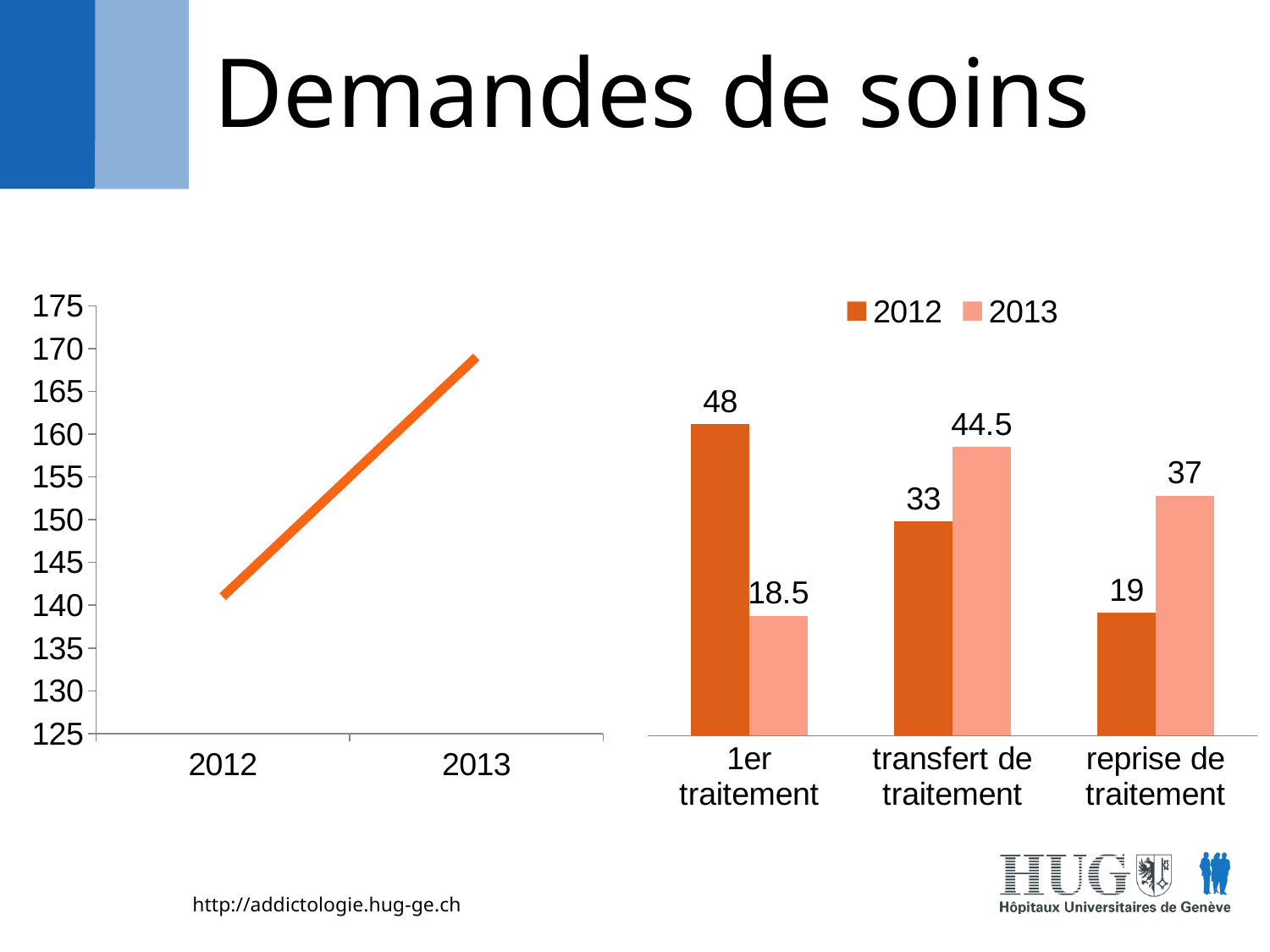
In the bar chart on the right, how many series does the legend list? 2 In the bar chart on the right, what is the 2013 value for reprise de traitement? 37 In the line chart on the left, is the value for 2012 greater or less than 145? less In the line chart on the left, does the value rise or fall from 2012 to 2013? rise In the bar chart on the right, which category has the highest 2012 value? 1er traitement What kind of chart is the chart on the left of the slide? line chart In the bar chart on the right, what is the 2013 value for transfert de traitement? 44.5 In the bar chart on the right, what is the difference between the 2012 and 2013 values for 1er traitement? 29.5 In the bar chart on the right, which category has the lowest 2013 value? 1er traitement In the bar chart on the right, what is the 2012 value for 1er traitement? 48 In the bar chart on the right, how many categories are shown on the x axis? 3 In the bar chart on the right, which is larger for reprise de traitement: the 2012 value or the 2013 value? 2013